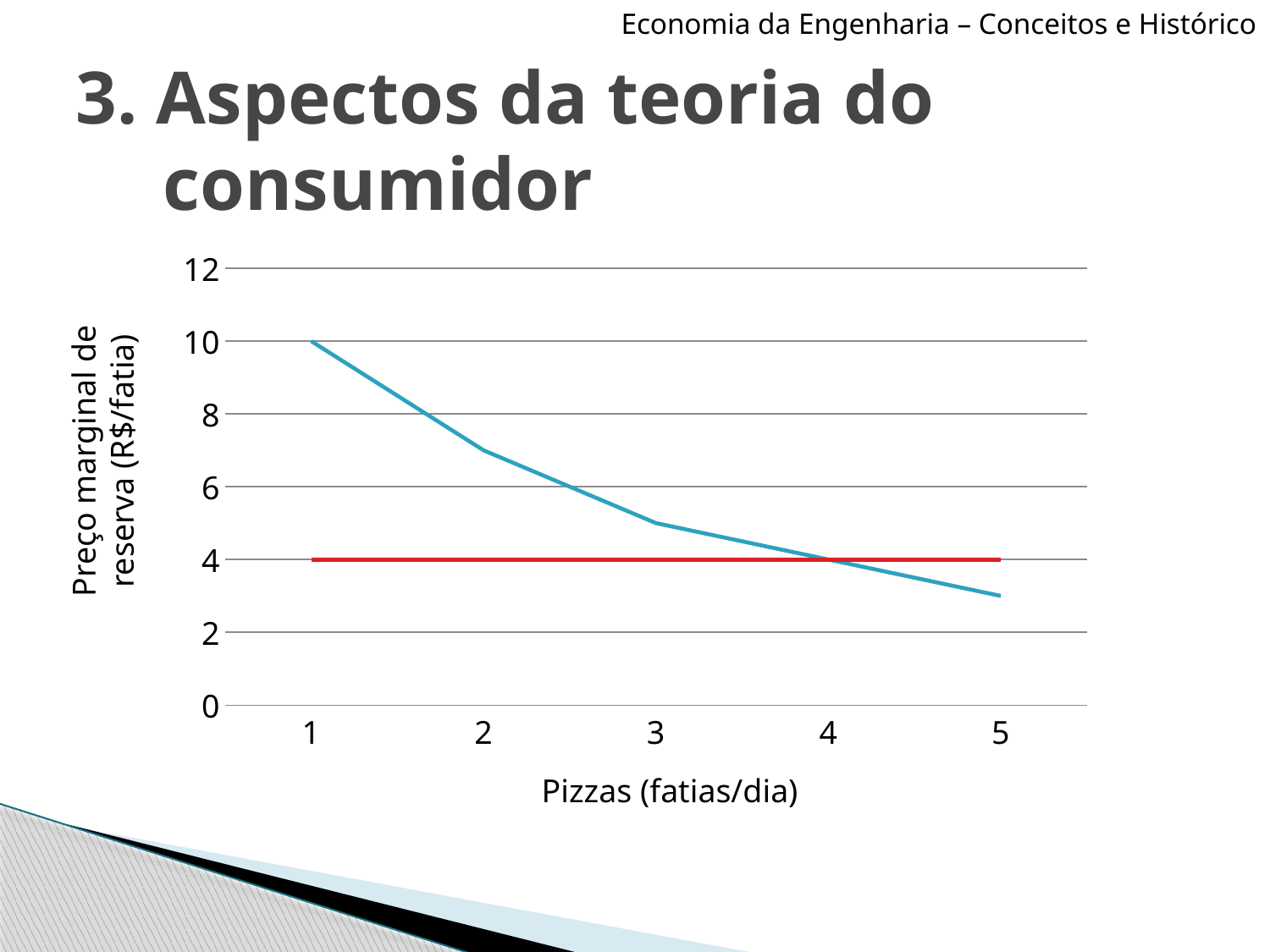
At what value does the red horizontal line sit? 4 What is the value of the blue line at 1 pizza slice per day? 10 At which x-axis value is the blue line highest? 1 How many points are marked on the x axis? 5 What kind of chart is shown on the slide? line chart At which x-axis value is the blue line lowest? 5 Which is larger: the blue line's value at 2 slices per day or at 3 slices per day? 2 slices per day What is the title of the x axis? Pizzas (fatias/dia) Is the value of the blue line at 3 slices per day greater or less than 6? less Is the value of the blue line at 5 slices per day greater or less than 4? less Does the blue line rise or fall as the number of pizza slices per day increases? falls Is the value of the blue line at 2 slices per day greater or less than 6? greater